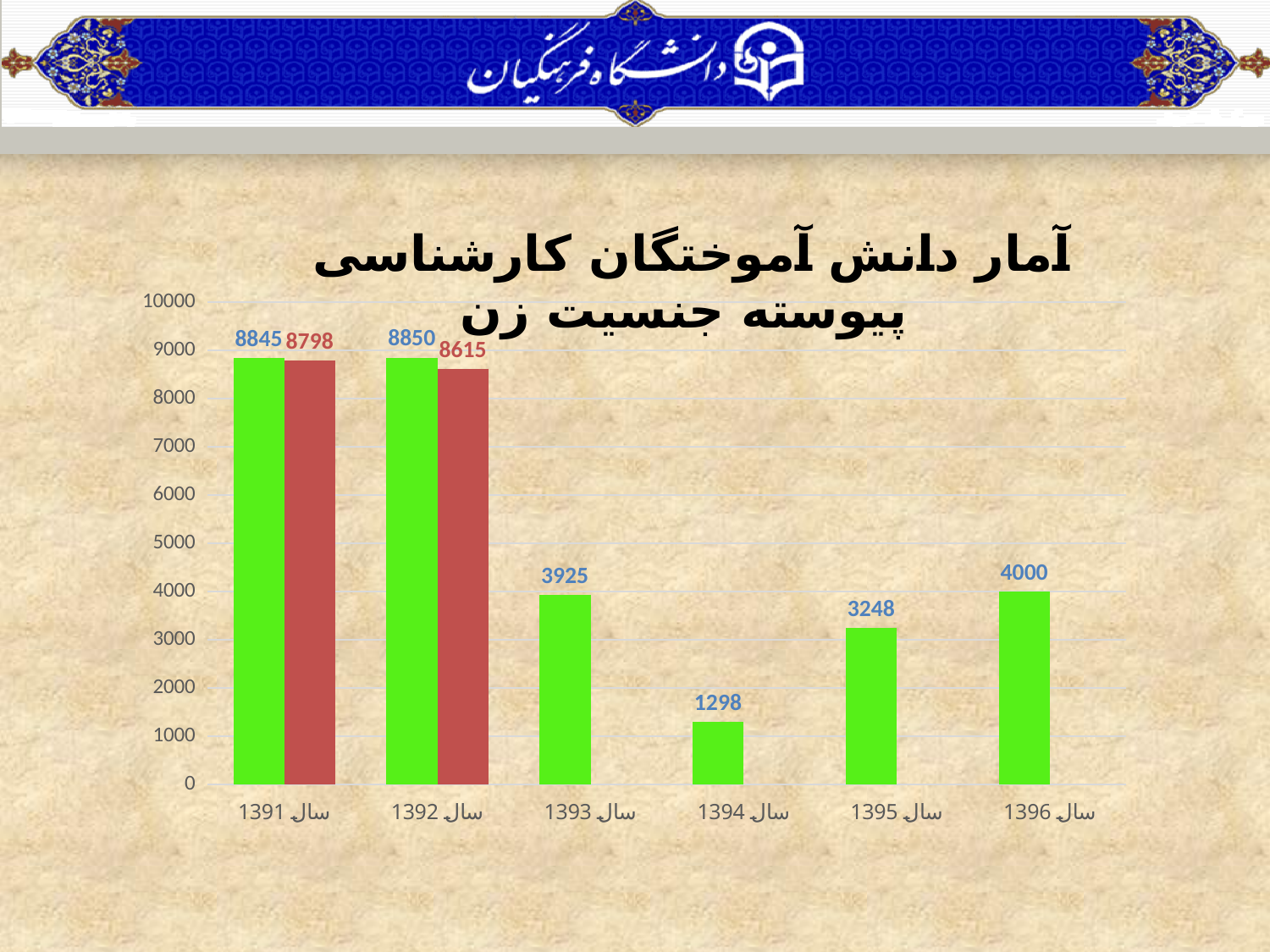
What kind of chart is shown on the slide? bar chart What is the value of the green bar for سال 1393? 3925 How many years have a red bar in addition to a green bar? 2 Which year has the highest green bar? سال 1392 What is the value of the red bar for سال 1392? 8615 What is the value of the green bar for سال 1396? 4000 How many year categories are shown on the x axis? 6 Which is larger, the green bar for سال 1393 or the green bar for سال 1395? سال 1393 Which year has the lowest green bar? سال 1394 What is the difference between the green bar and the red bar for سال 1391? 47 What is the difference between the green bars for سال 1396 and سال 1395? 752 Is the green bar for سال 1394 greater or less than 2000? less